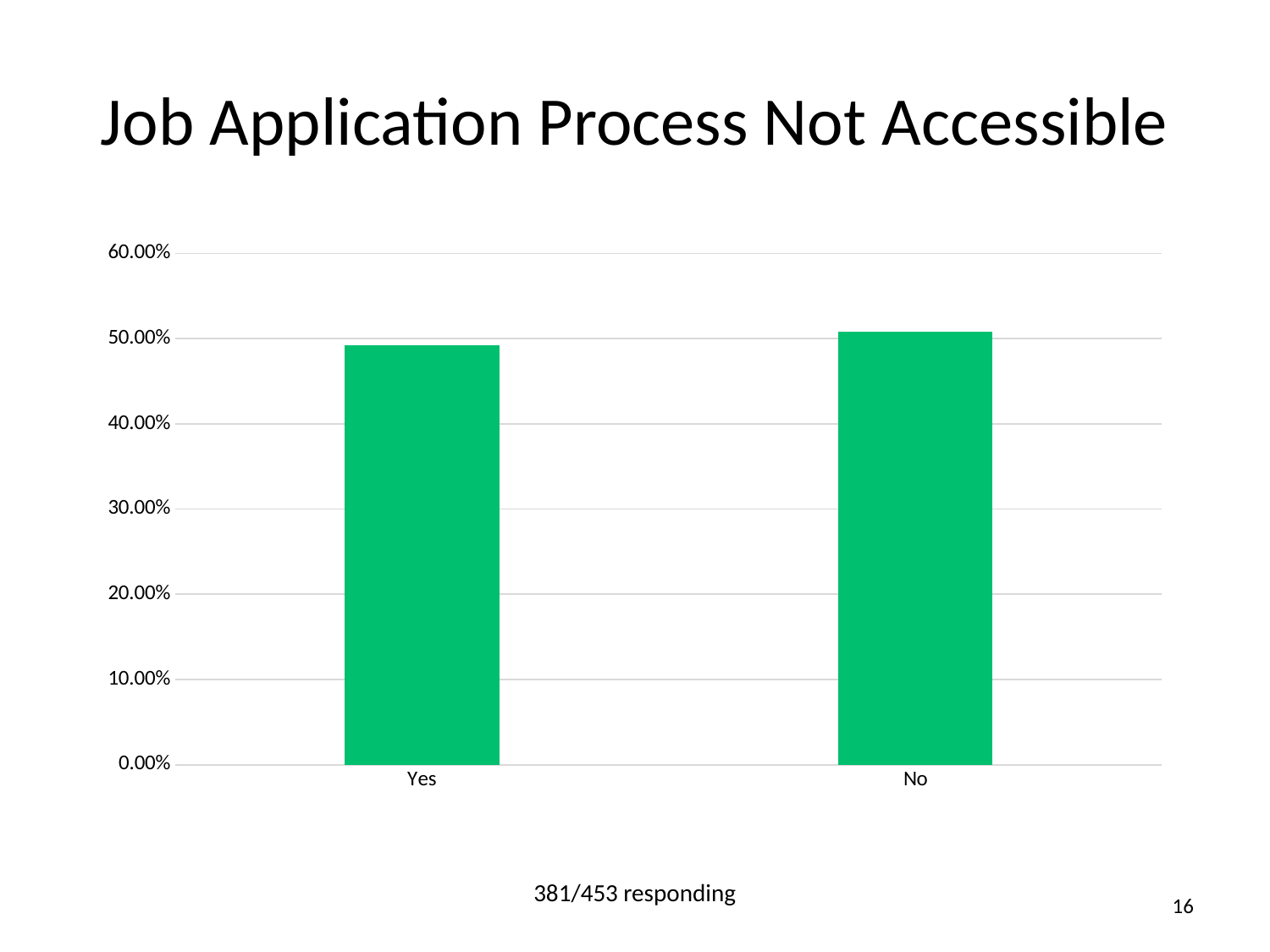
Is the value for No greater or less than 60.00%? less Which category has the higher bar, Yes or No? No What is the title of the chart? Job Application Process Not Accessible What is the highest value shown on the vertical axis? 60.00% Is the value for Yes greater or less than 50.00%? less How many categories are plotted on the chart? 2 Which category has the highest value? No What colour are the bars in the chart? green What kind of chart is shown on the slide? bar chart Is the value for Yes greater or less than 40.00%? greater Which category has the lowest value? Yes